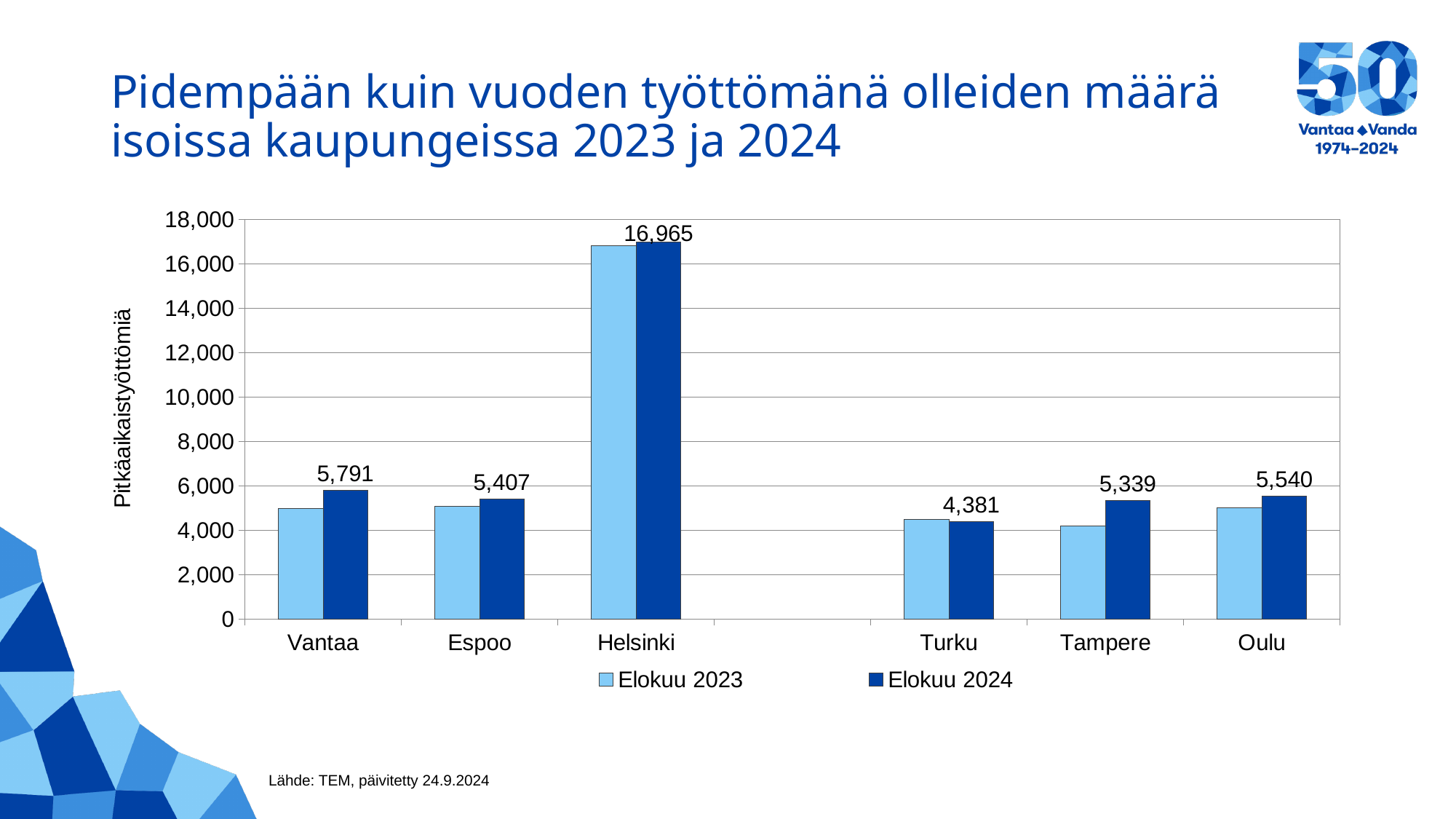
What is the value for Oulu in Elokuu 2024? 5,540 How many cities are shown on the x axis? 6 What kind of chart is shown on the slide? bar chart What is the value for Turku in Elokuu 2024? 4,381 Which is larger for Tampere: the Elokuu 2023 value or the Elokuu 2024 value? Elokuu 2024 What is the difference between the Elokuu 2024 values for Vantaa and Espoo? 384 How many series does the legend list? 2 Which city has the highest value in Elokuu 2024? Helsinki What is the value for Vantaa in Elokuu 2024? 5,791 Is the Elokuu 2023 value for Helsinki greater or less than 16,000? greater Which city has the lowest value in Elokuu 2024? Turku What is the value for Helsinki in Elokuu 2024? 16,965